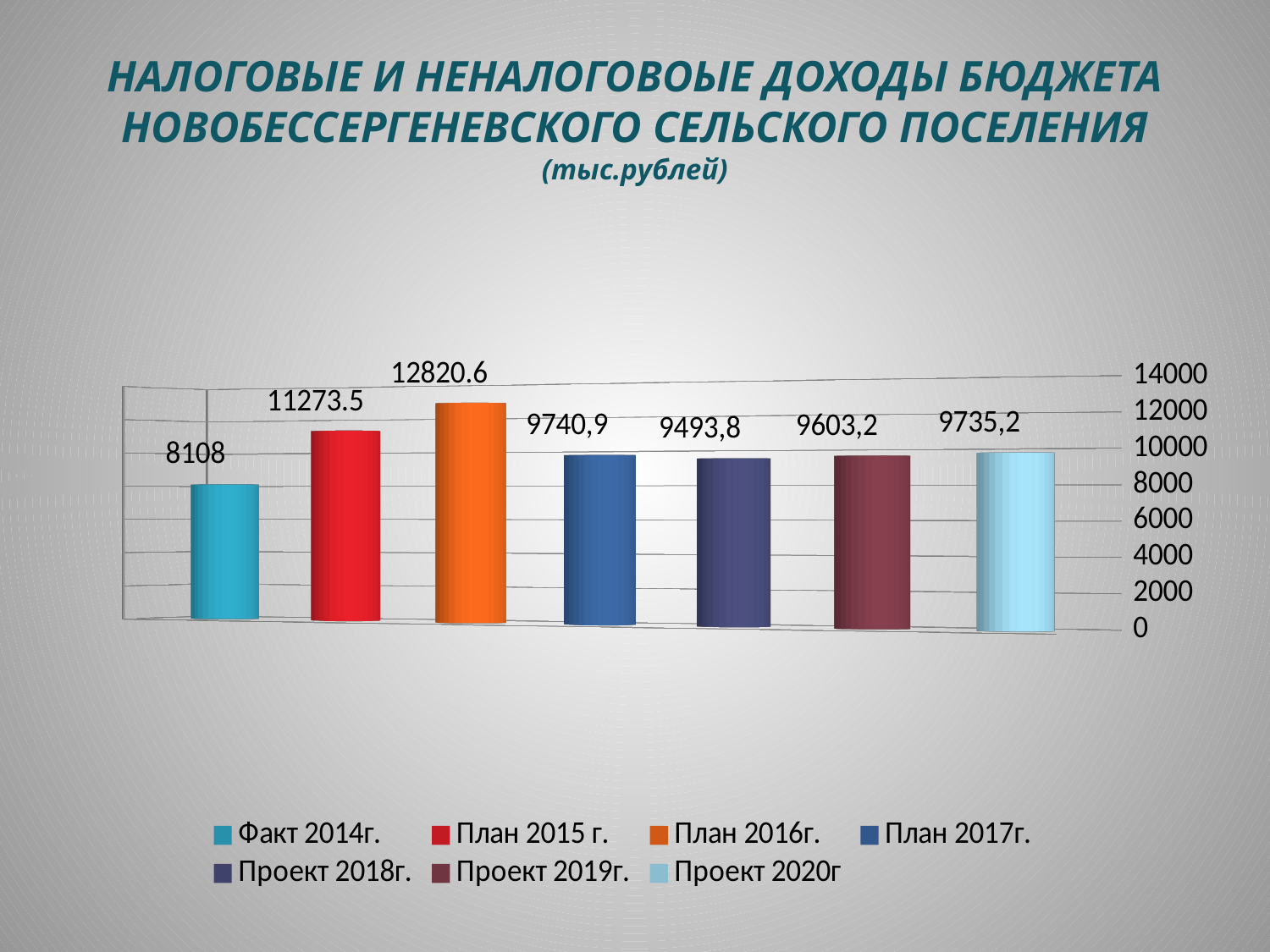
How many series does the legend list? 7 What kind of chart is shown on the slide? bar chart Which series has the highest value? План 2016г. How many bars are plotted on the chart? 7 What is the value for Факт 2014г.? 8108 What is the difference between the values for План 2017г. and Проект 2018г.? 247,1 Is the value for Факт 2014г. greater or less than 10000? less Which series has the lowest value? Факт 2014г. Which is larger, the value for Проект 2019г. or Проект 2020г? Проект 2020г What is the difference between the values for План 2016г. and План 2015 г.? 1547.1 What is the value for План 2016г.? 12820.6 What is the value for Проект 2019г.? 9603,2